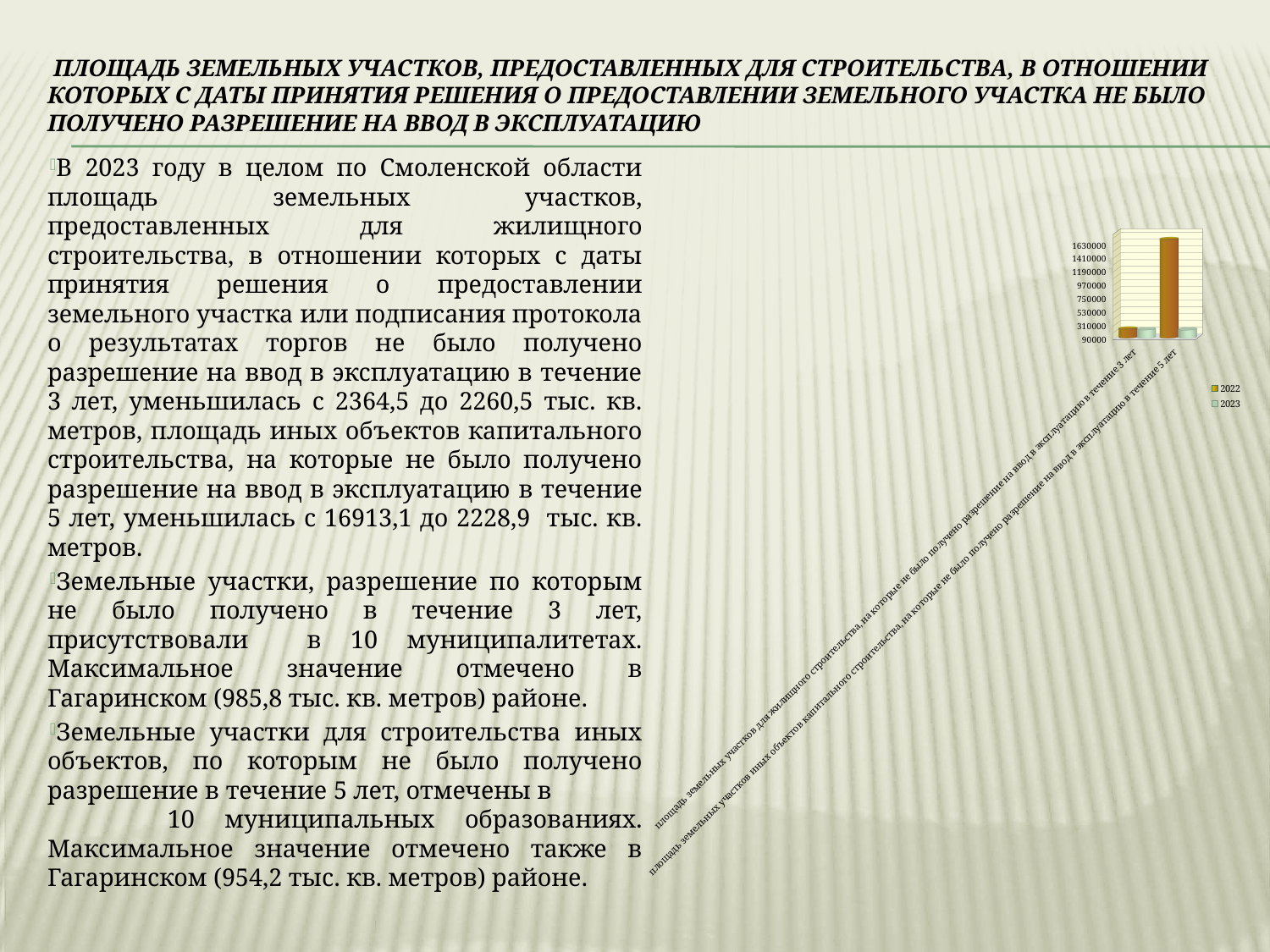
Which years are listed in the chart legend? 2022 and 2023 For the second category (иных объектов капитального строительства, 5 лет), which series has the larger value, 2022 or 2023? 2022 How many categories are plotted on the chart's x axis? 2 Is the 2022 value for the second category (иных объектов капитального строительства, 5 лет) greater or less than 1410000? greater How many series does the chart legend list? 2 Is the 2023 value for the second category (иных объектов капитального строительства, 5 лет) greater or less than 530000? less Is the 2022 value for the first category (жилищного строительства, 3 лет) greater or less than 750000? less Which bar is the tallest on the chart? 2022, иных объектов капитального строительства (5 лет) What kind of chart is shown on the right side of the slide? bar chart What is the highest tick value shown on the chart's vertical axis? 1630000